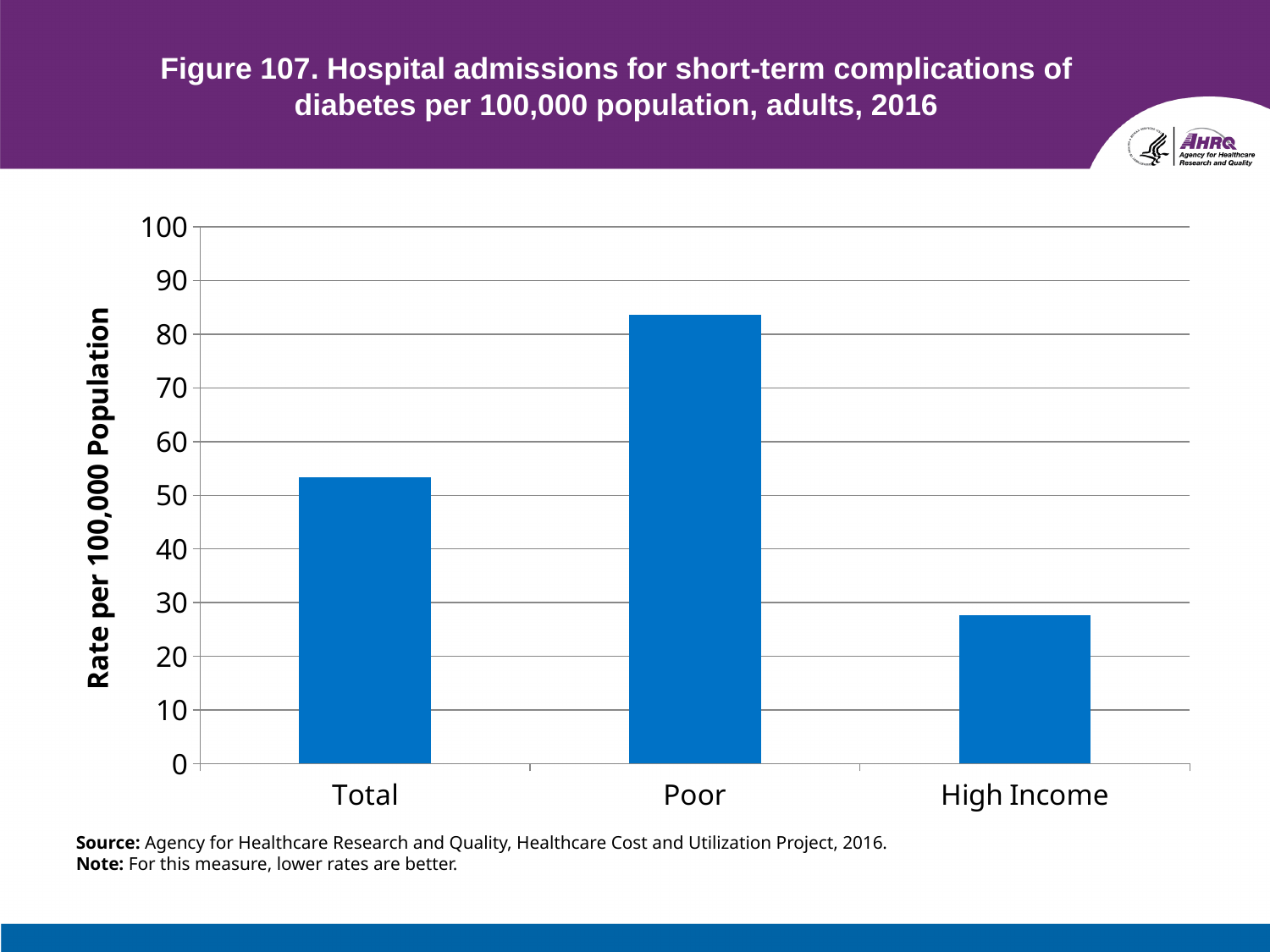
Is the value for Poor greater or less than 80? greater Is the value for Poor greater or less than 90? less Is the value for Total greater or less than 50? greater What is the label of the y axis? Rate per 100,000 Population Which is larger, the value for Total or the value for High Income? Total Which is larger, the value for Poor or the value for Total? Poor What kind of chart is shown on the slide? bar chart What year does the chart title say the data are for? 2016 Which category has the highest rate? Poor How many categories are shown on the x axis? 3 Which category has the lowest rate? High Income